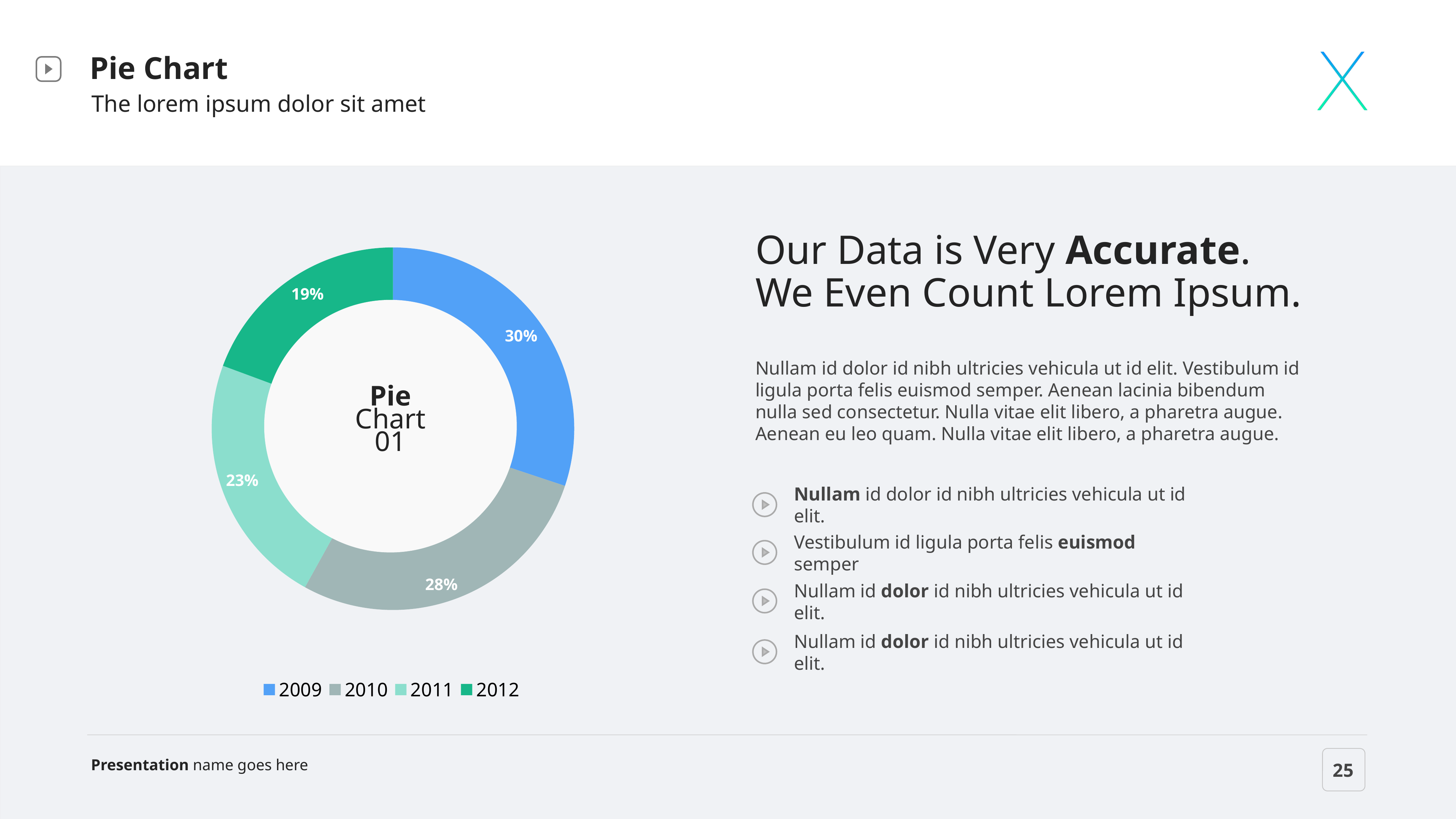
What percentage does the 2009 slice represent? 30% What kind of chart is shown on the slide? Pie chart How many slices does the pie chart have? 4 What percentage does the 2011 slice represent? 23% How many entries does the legend list? 4 Which year has the smallest slice of the pie? 2012 What is the difference in percentage points between the 2009 and 2012 slices? 11 Which year has the largest slice of the pie? 2009 What percentage does the 2010 slice represent? 28% What colour is the 2009 slice? Blue What percentage does the 2012 slice represent? 19% Which slice is larger, 2011 or 2012? 2011